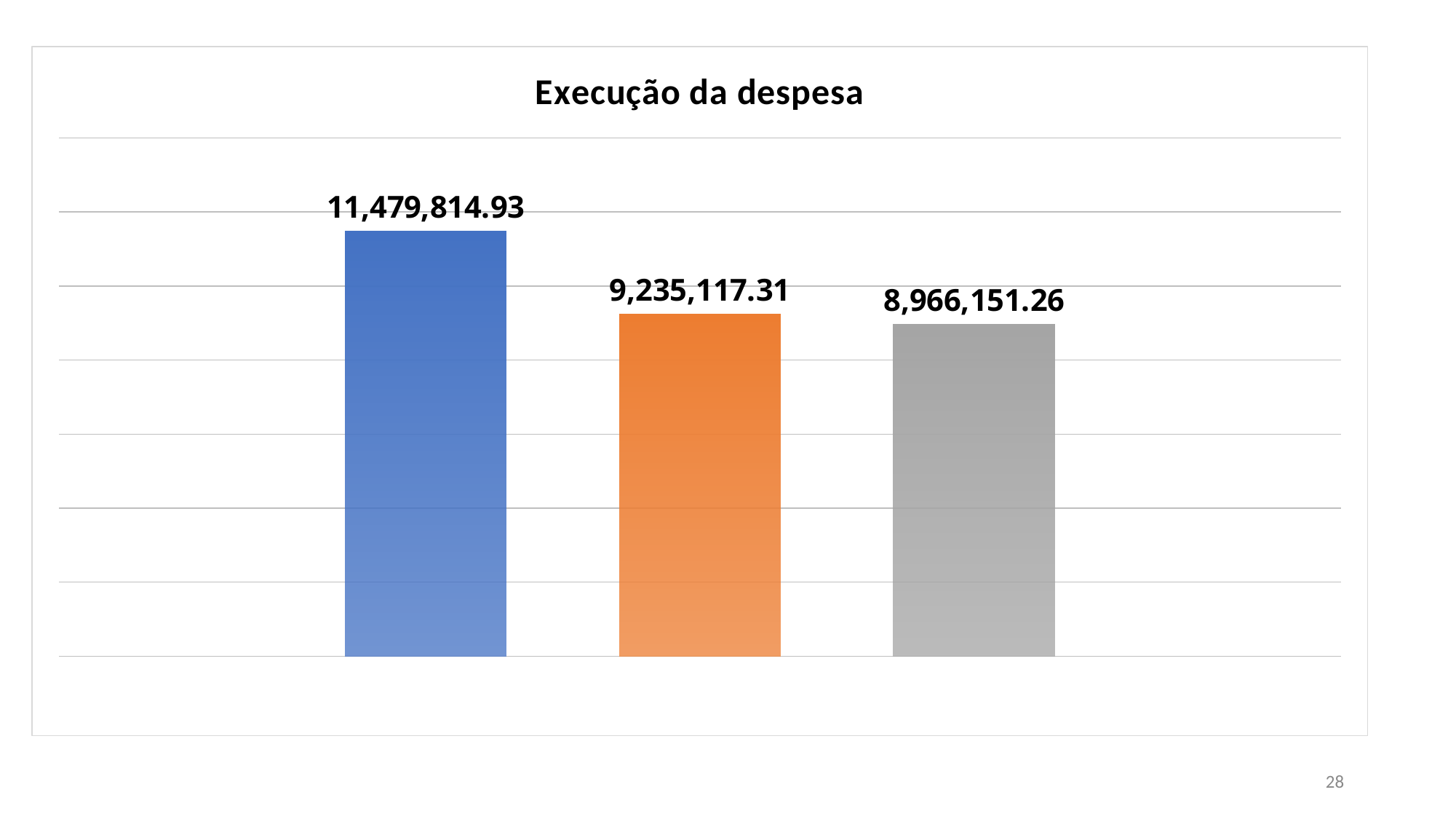
What is the title of the chart? Execução da despesa What kind of chart is shown on the slide? bar chart Which bar has the highest value? the blue (leftmost) bar What is the value shown on the blue (leftmost) bar? 11,479,814.93 What is the value shown on the grey (rightmost) bar? 8,966,151.26 Which bar has the lowest value? the grey (rightmost) bar What is the value shown on the orange (middle) bar? 9,235,117.31 What is the difference between the orange bar's value and the grey bar's value? 268,966.05 What is the difference between the blue bar's value and the orange bar's value? 2,244,697.62 Which is larger, the value of the orange bar or the value of the grey bar? the orange bar How many bars are plotted in the chart? 3 Do the values rise or fall from left to right across the bars? fall